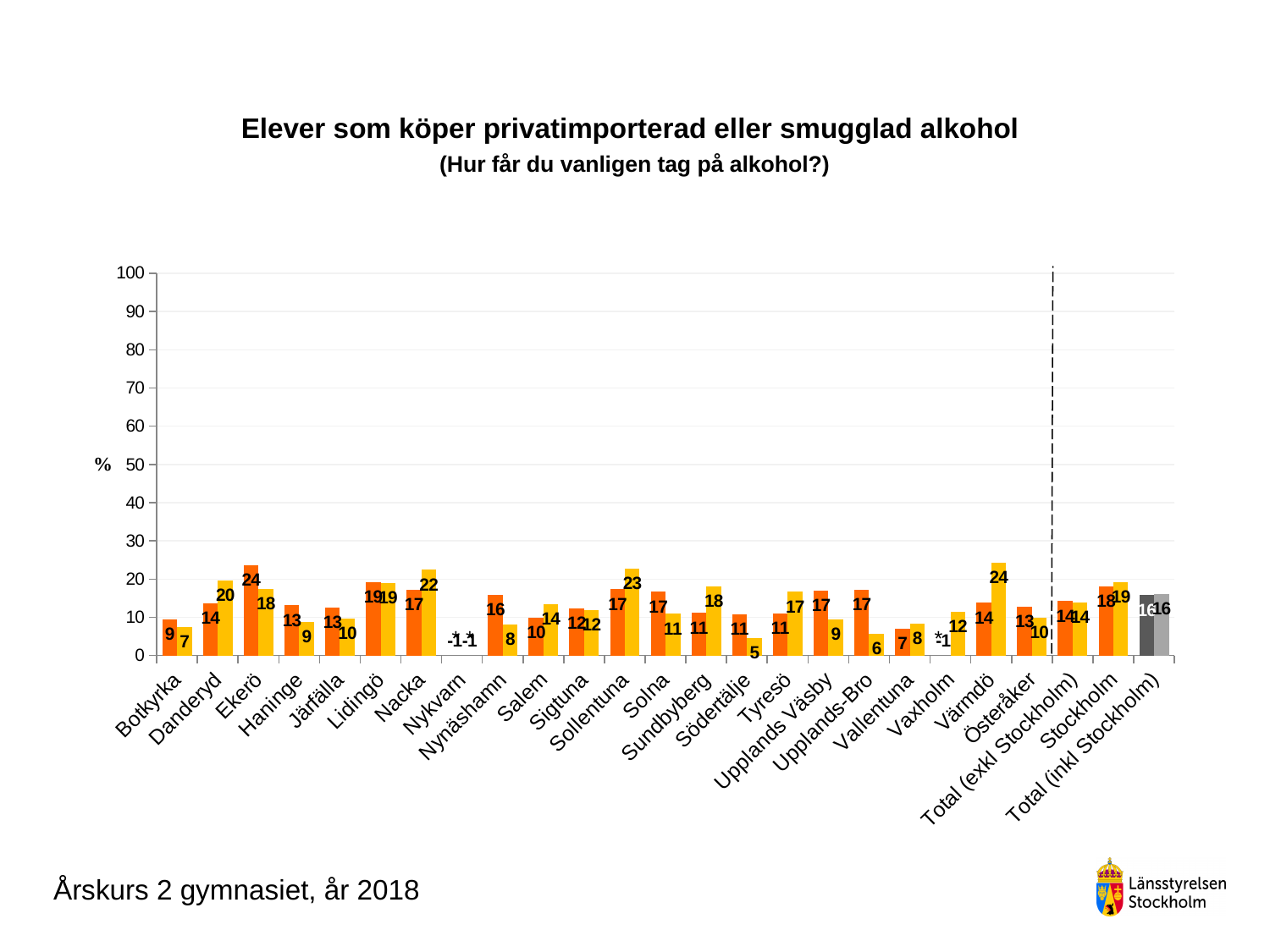
What is the value of the yellow bar for Värmdö? 24 What kind of chart is shown on the slide? bar chart What is the value of the orange bar for Ekerö? 24 Which municipality has the highest orange bar? Ekerö What is the value of the yellow bar for Sollentuna? 23 For Nacka, which bar is larger, the orange one or the yellow one? the yellow one What value is shown for both bars of Total (inkl Stockholm)? 16 What is the difference between the yellow bar and the orange bar for Danderyd? 6 Is the value of the yellow bar for Sollentuna greater or less than 20? greater How many categories are shown on the x axis? 25 What is the title of the chart? Elever som köper privatimporterad eller smugglad alkohol Which municipality has the highest yellow bar? Värmdö